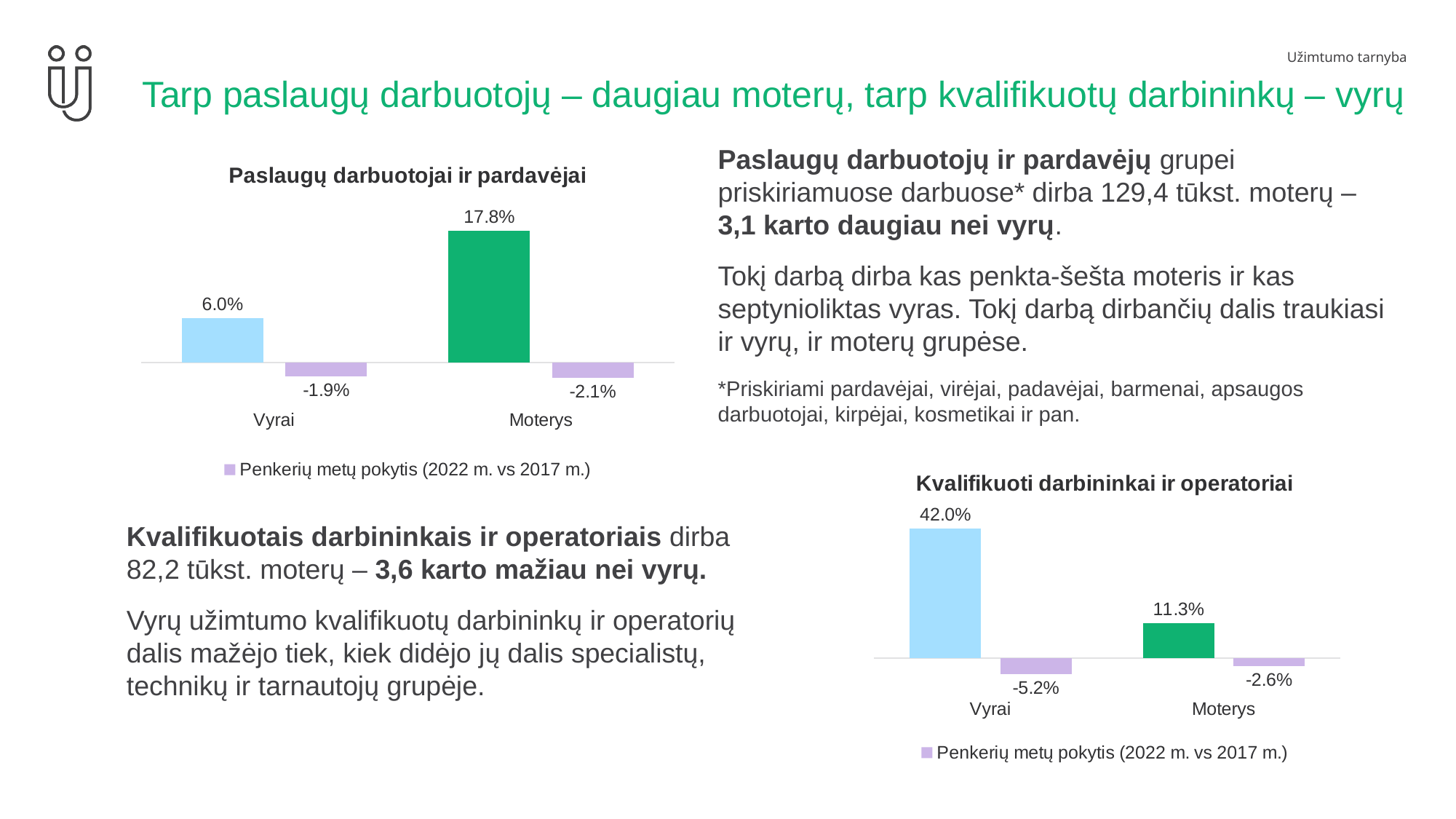
In the chart titled 'Kvalifikuoti darbininkai ir operatoriai', what is the difference between the Vyrai value and the Moterys value? 30.7% In the chart titled 'Kvalifikuoti darbininkai ir operatoriai', what is the legend entry shown? Penkerių metų pokytis (2022 m. vs 2017 m.) In the chart titled 'Paslaugų darbuotojai ir pardavėjai', what is the five-year change (Penkerių metų pokytis) for Vyrai? -1.9% In the chart titled 'Kvalifikuoti darbininkai ir operatoriai', what is the five-year change (Penkerių metų pokytis) for Vyrai? -5.2% In the chart titled 'Kvalifikuoti darbininkai ir operatoriai', what is the value shown for Vyrai? 42.0% In the chart titled 'Kvalifikuoti darbininkai ir operatoriai', which category has the higher main value, Vyrai or Moterys? Vyrai In the chart titled 'Kvalifikuoti darbininkai ir operatoriai', what is the value shown for Moterys? 11.3% In the chart titled 'Paslaugų darbuotojai ir pardavėjai', what is the value shown for Moterys? 17.8% In the chart titled 'Paslaugų darbuotojai ir pardavėjai', what is the five-year change (Penkerių metų pokytis) for Moterys? -2.1% In the chart titled 'Paslaugų darbuotojai ir pardavėjai', what is the difference between the Moterys value and the Vyrai value? 11.8% In the chart titled 'Paslaugų darbuotojai ir pardavėjai', what is the value shown for Vyrai? 6.0% What type of chart is the chart titled 'Paslaugų darbuotojai ir pardavėjai'? Bar chart